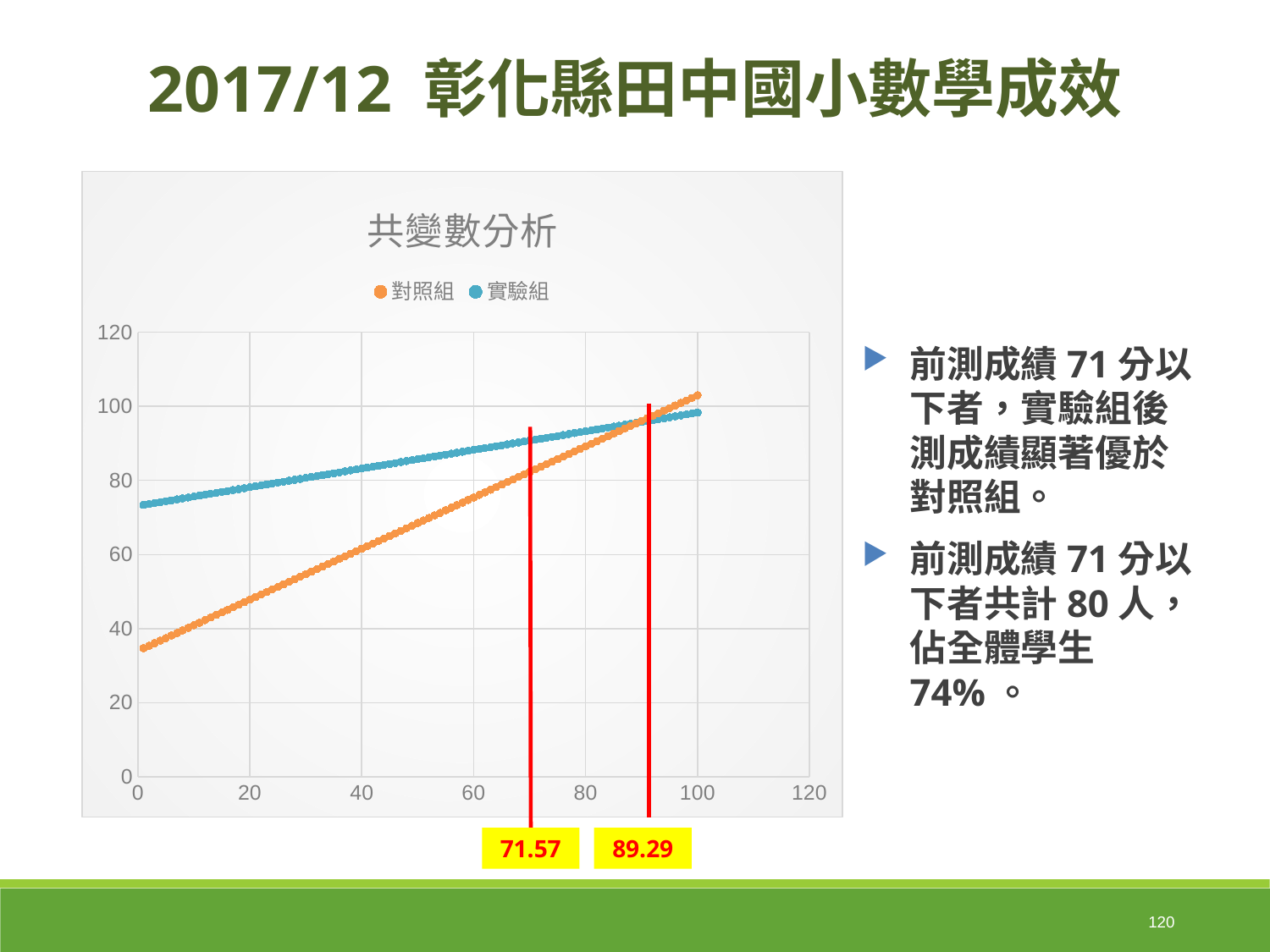
What is the title of the chart? 共變數分析 Do the values of the 實驗組 series rise or fall as the x axis increases? rise Which series is shown in orange in the chart? 對照組 What x-axis value is marked by the left red vertical line, according to the yellow label below the chart? 71.57 Is the value of the 實驗組 series at x = 0 greater or less than 60? greater What kind of chart is shown on the slide? scatter chart Is the value of the 對照組 series at x = 0 greater or less than 40? less Is the value of the 對照組 series at x = 100 greater or less than 100? greater Do the values of the 對照組 series rise or fall as the x axis increases? rise How many series does the legend of the 共變數分析 chart list? 2 At x = 20, which series has the higher value, 對照組 or 實驗組? 實驗組 At x = 100, which series has the higher value, 對照組 or 實驗組? 對照組